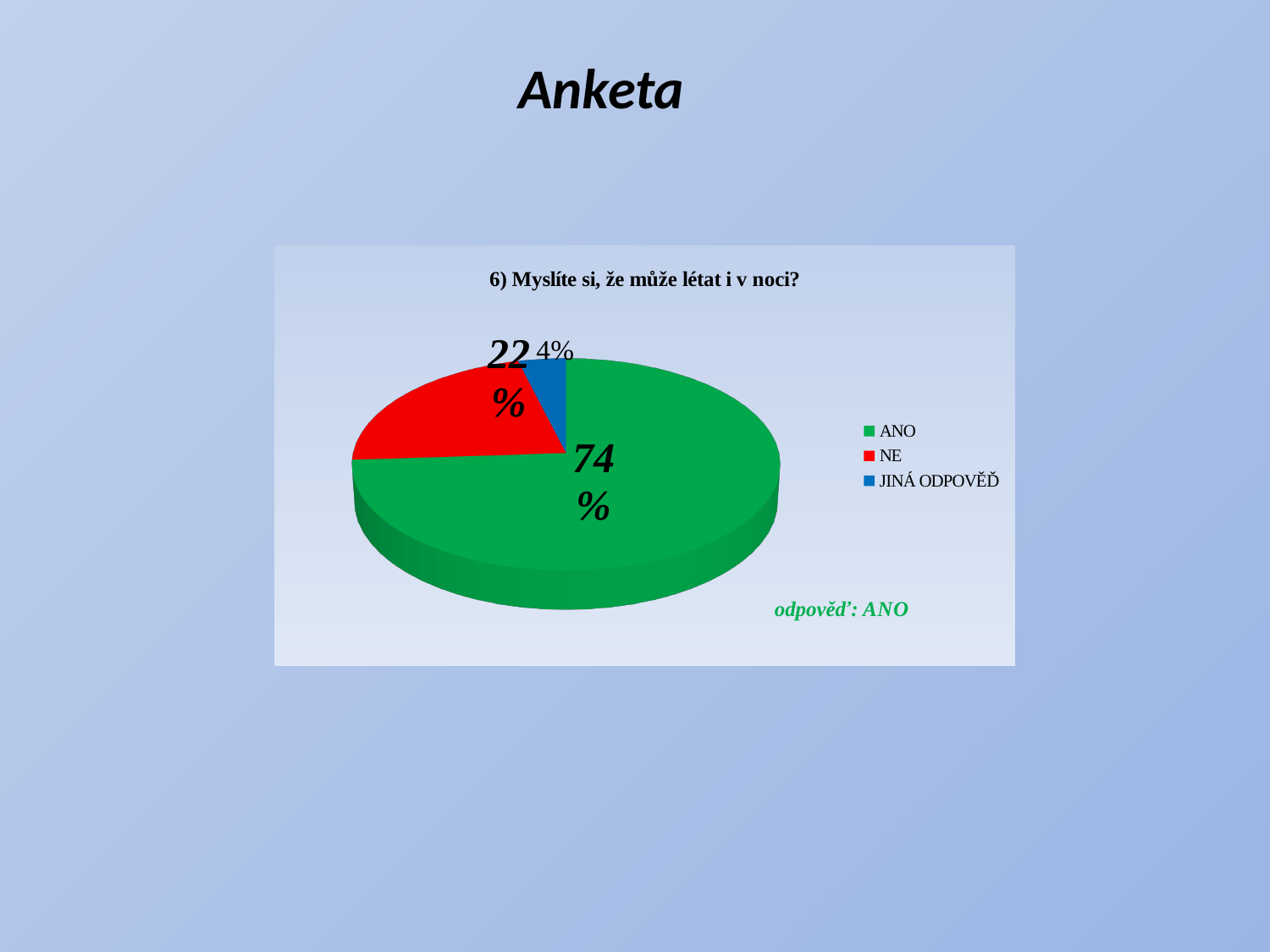
What colour is the NE slice in the pie chart? red Which category has the smallest slice of the pie? JINÁ ODPOVĚĎ What is the difference in percentage points between the NE and JINÁ ODPOVĚĎ slices? 18 How many categories does the pie chart show? 3 What share of the pie does NE have? 22% What is the title of the chart? 6) Myslíte si, že může létat i v noci? Which category has the largest slice of the pie? ANO What share of the pie does JINÁ ODPOVĚĎ have? 4% What share of the pie does ANO have? 74% Which is larger, the NE slice or the JINÁ ODPOVĚĎ slice? NE What kind of chart is shown on the slide? pie chart What is the difference in percentage points between the ANO and NE slices? 52